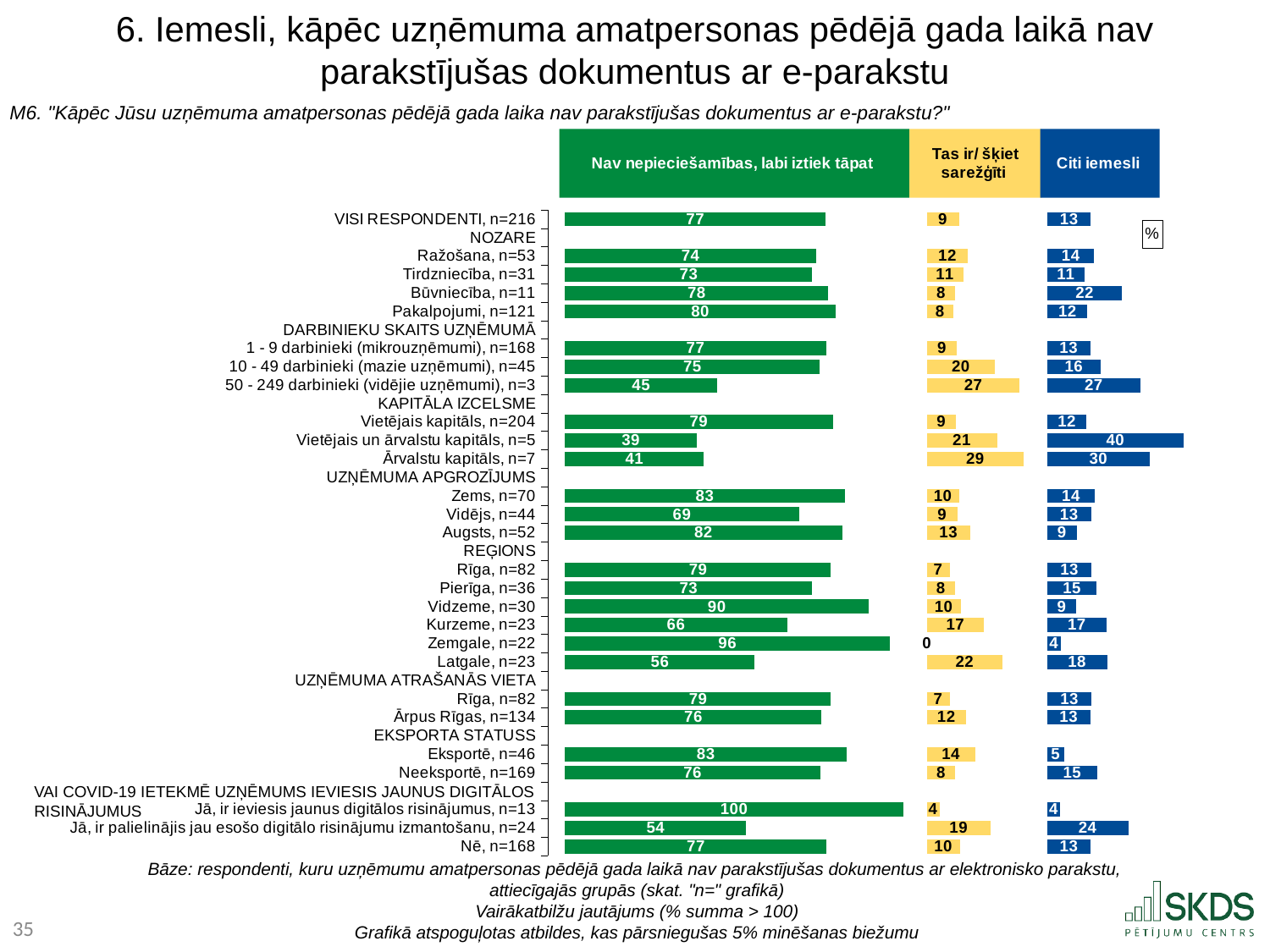
Which category has the lowest value for "Nav nepieciešamības, labi iztiek tāpat"? Vietējais un ārvalstu kapitāls, n=5 What is the value of "Citi iemesli" for Zemgale, n=22? 4 Which category has the highest value for "Nav nepieciešamības, labi iztiek tāpat"? Jā, ir ieviesis jaunus digitālos risinājumus, n=13 What kind of chart is shown on the slide? bar chart What is the value of "Nav nepieciešamības, labi iztiek tāpat" for VISI RESPONDENTI, n=216? 77 What is the value of "Tas ir/ šķiet sarežģīti" for Ārvalstu kapitāls, n=7? 29 How many series does the chart legend list? 3 Which category has the highest value for "Citi iemesli"? Vietējais un ārvalstu kapitāls, n=5 What colour are the bars for the "Citi iemesli" series? blue What is the value of "Tas ir/ šķiet sarežģīti" for Zemgale, n=22? 0 Which has the larger "Nav nepieciešamības, labi iztiek tāpat" value, Vidzeme, n=30 or Kurzeme, n=23? Vidzeme, n=30 What is the difference between the "Nav nepieciešamības, labi iztiek tāpat" values for Pakalpojumi, n=121 and Ražošana, n=53? 6